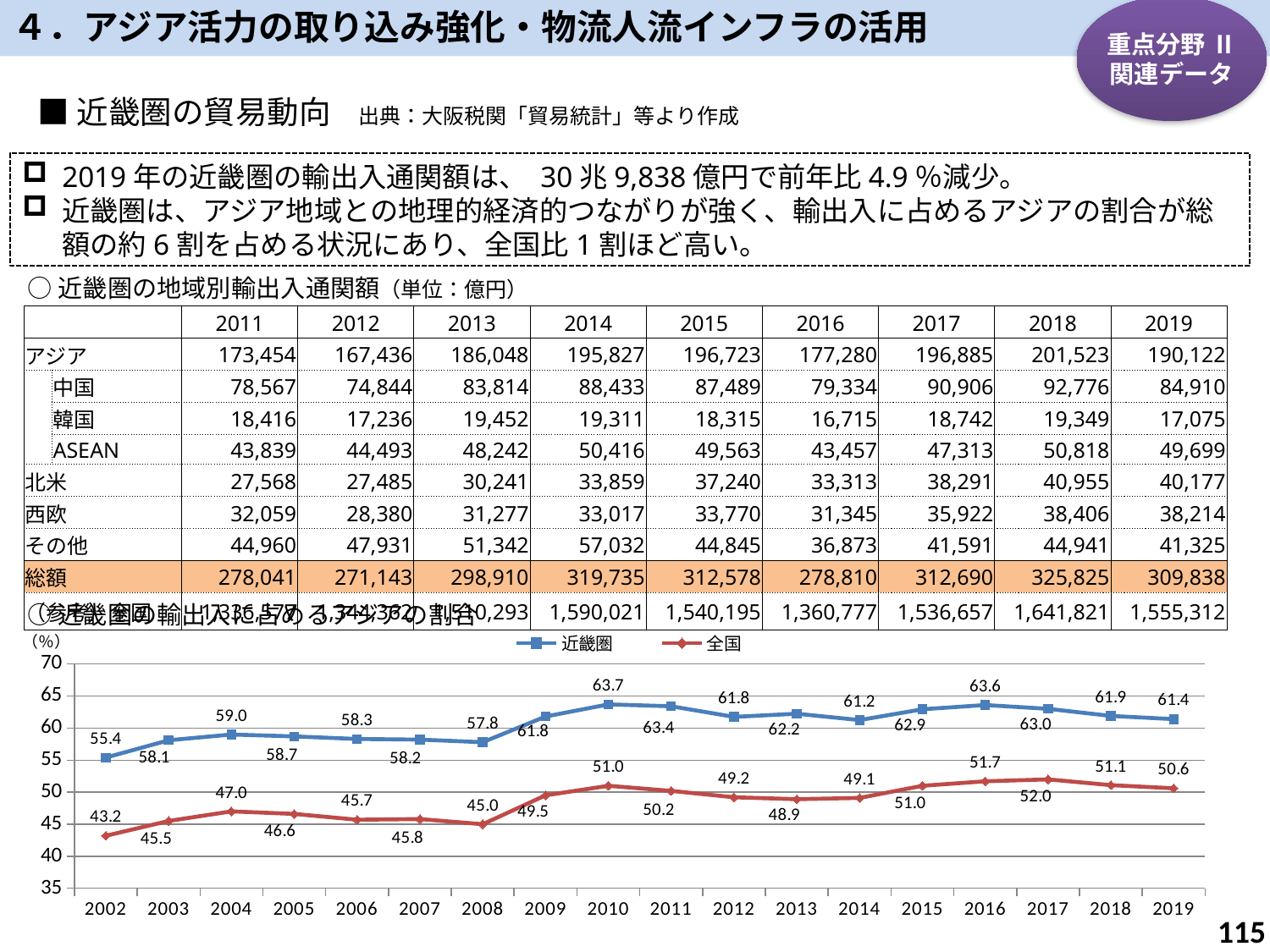
On the line chart, what is the difference between the 近畿圏 value and the 全国 value in 2019? 10.8 What is the value for 全国 in 2002 on the line chart? 43.2 What is the value for 近畿圏 in 2010 on the line chart? 63.7 What kind of chart is shown at the bottom of the slide? line chart On the line chart, is the 全国 value higher in 2008 or in 2009? 2009 What is the value for 近畿圏 in 2019 on the line chart? 61.4 How many series does the legend of the line chart list? 2 In which year is the 近畿圏 series at its lowest on the line chart? 2002 On the line chart, by how much did the 全国 value increase from 2002 to 2010? 7.8 Is the 近畿圏 value for 2002 on the line chart greater or less than 60? less How many years are shown on the x axis of the line chart? 18 In which year is the 全国 series at its lowest on the line chart? 2002